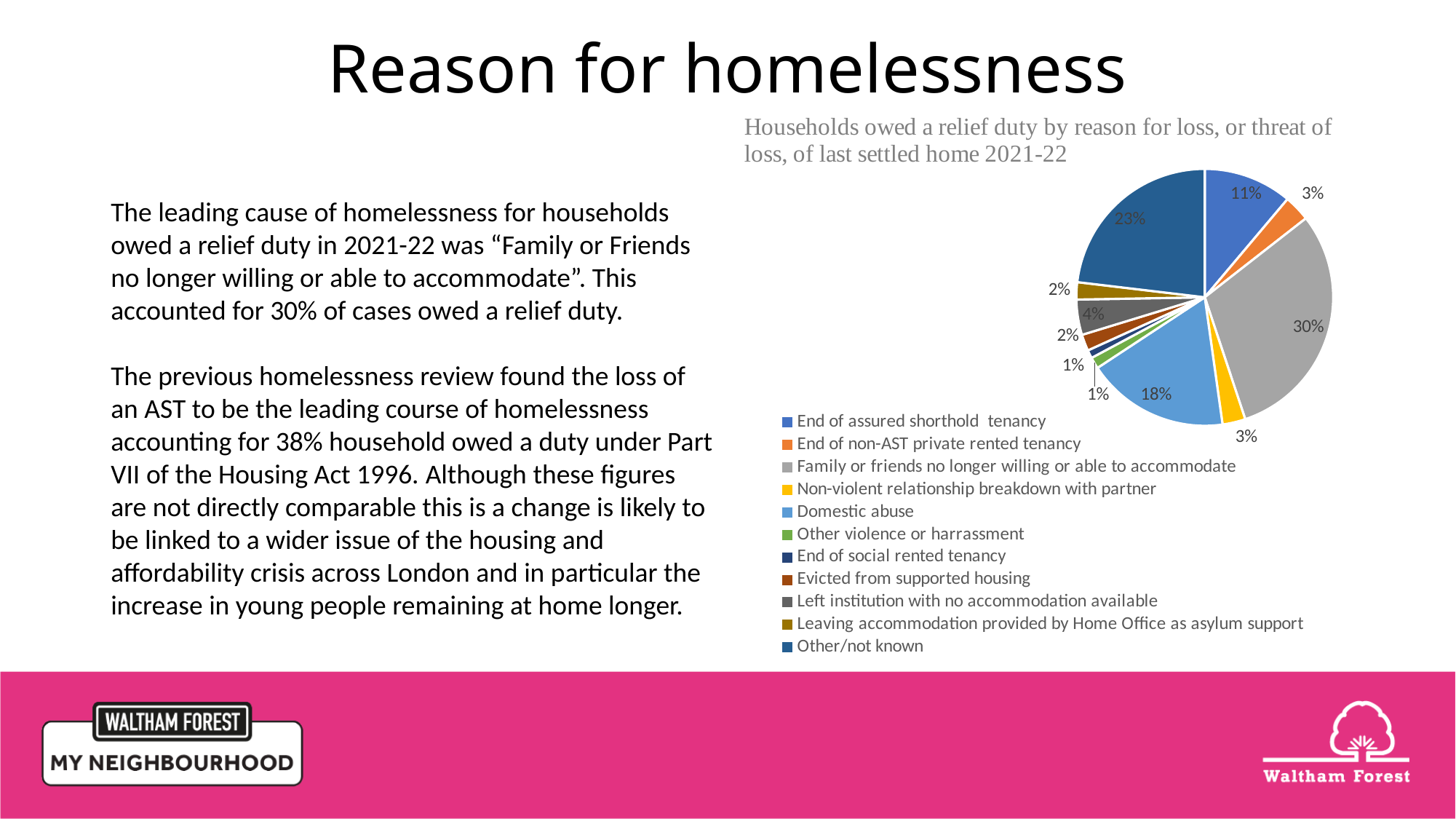
What colour is the slice for 'Non-violent relationship breakdown with partner'? yellow What is the title of the pie chart? Households owed a relief duty by reason for loss, or threat of loss, of last settled home 2021-22 What percentage is shown for 'Other/not known'? 23% How many categories does the legend of the pie chart list? 11 Which reason accounts for the largest share of the pie? Family or friends no longer willing or able to accommodate Which is larger: the share for 'Domestic abuse' or the share for 'End of assured shorthold tenancy'? Domestic abuse What percentage is shown for 'Left institution with no accommodation available'? 4% What share of households owed a relief duty is attributed to 'Family or friends no longer willing or able to accommodate'? 30% What percentage of the pie is 'Domestic abuse'? 18% What is the difference in percentage points between 'Family or friends no longer willing or able to accommodate' and 'Other/not known'? 7 What percentage is shown for 'End of assured shorthold tenancy'? 11% What type of chart is shown on the slide? pie chart